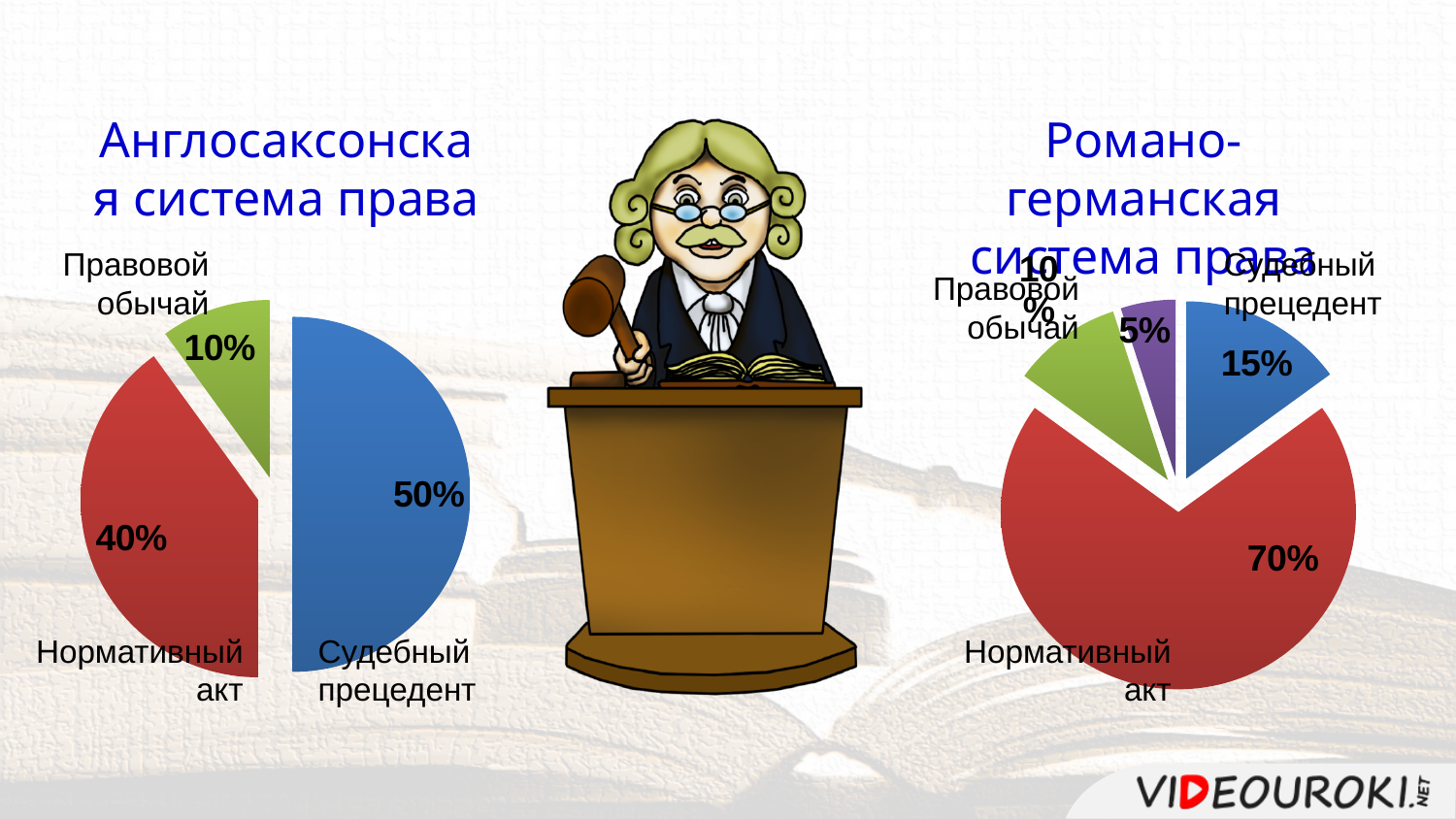
In the Англосаксонская система права chart, which category has the largest share? Судебный прецедент In the Романо-германская система права chart, what share does Нормативный акт have? 70% In the Англосаксонская система права chart, which category has the smallest share? Правовой обычай What kind of chart is used for the Англосаксонская система права? pie chart How many slices does the Романо-германская система права pie chart have? 4 In the Романо-германская система права chart, what share does Судебный прецедент have? 15% In the Романо-германская система права chart, which category has the largest share? Нормативный акт In the Англосаксонская система права chart, what share does Правовой обычай have? 10% In the Англосаксонская система права chart, what share does Судебный прецедент have? 50% In the Англосаксонская система права chart, what share does Нормативный акт have? 40% How many slices does the Англосаксонская система права pie chart have? 3 What is the difference between the share of Нормативный акт in the Романо-германская система права chart and in the Англосаксонская система права chart? 30%